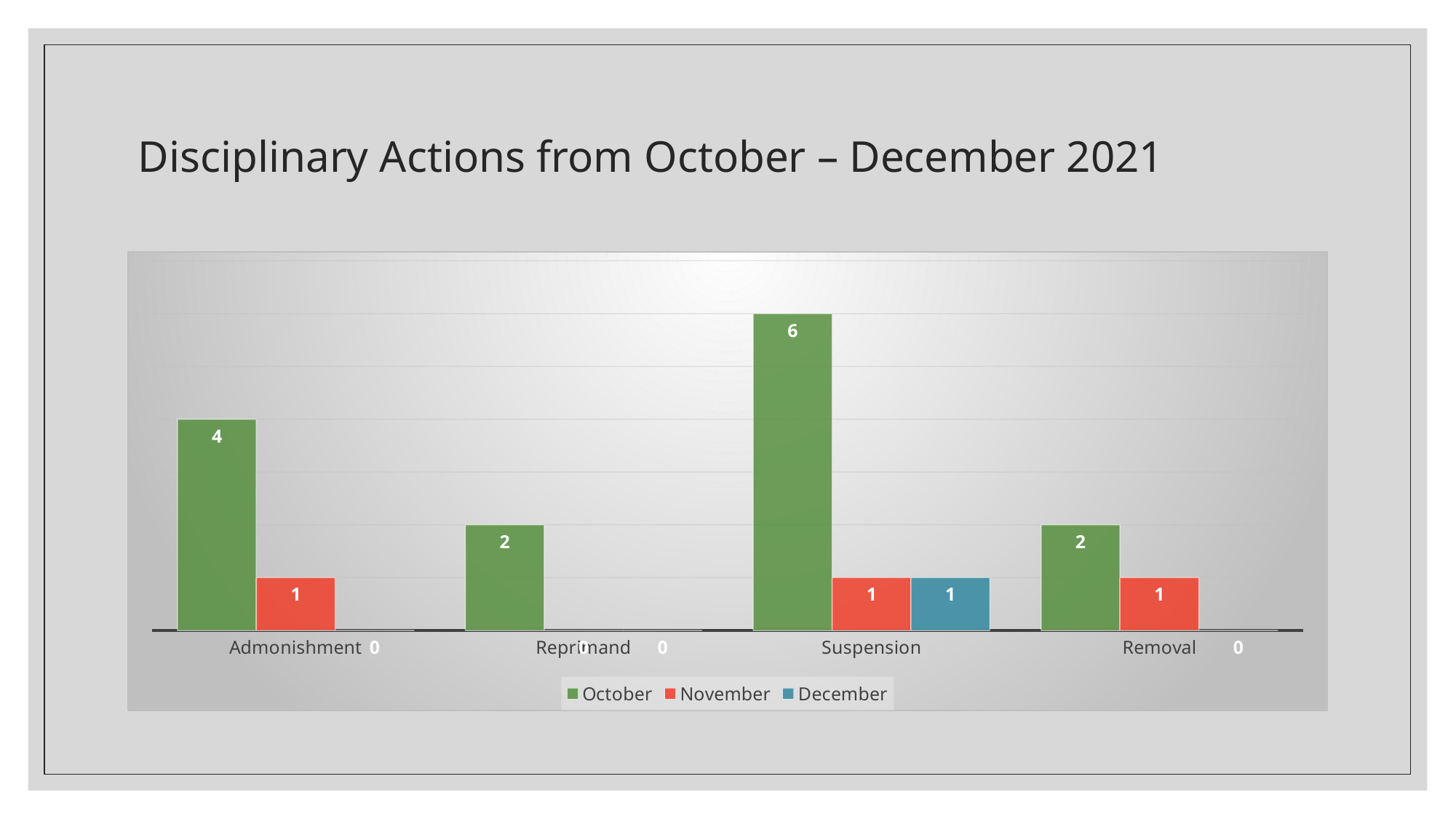
What kind of chart is shown on the slide? Bar chart What is the November value for Removal? 1 How many categories are shown on the x axis? 4 Which category has the highest October value? Suspension What is the difference between the October values for Suspension and Admonishment? 2 Which series is shown in green? October Which is larger, the October value for Admonishment or the October value for Reprimand? Admonishment What is the October value for Admonishment? 4 What is the October value for Suspension? 6 How many series does the legend list? 3 What is the title of the chart? Disciplinary Actions from October – December 2021 What is the December value for Suspension? 1